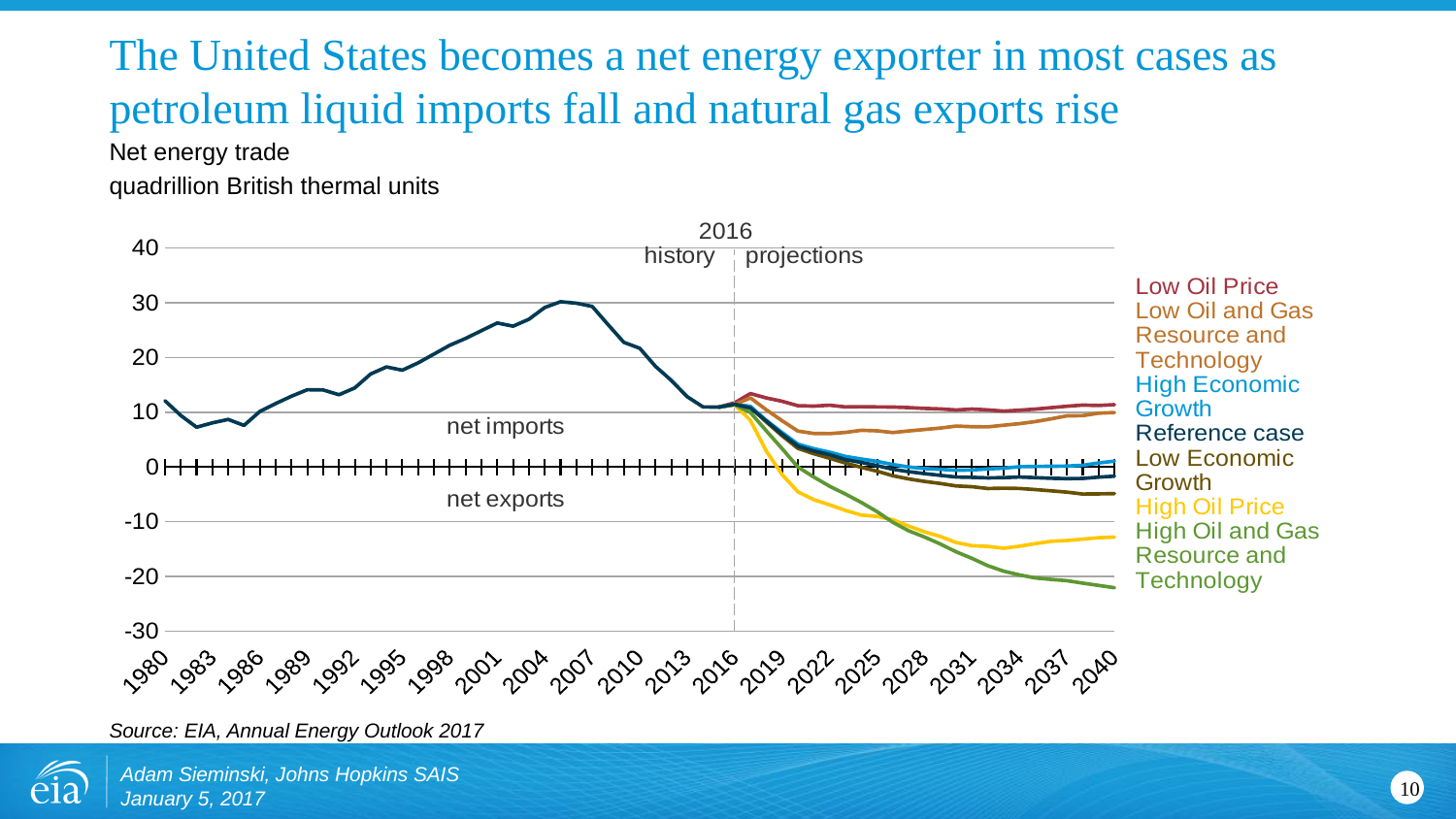
In 2040, is the value for the High Oil and Gas Resource and Technology case greater or less than -10? less Does the historical net energy trade line rise or fall between 2005 and 2016? fall In 2040, which is larger: the Reference case or the Low Economic Growth case? Reference case Is the peak historical value around 2005 greater or less than 20? greater What kind of chart is shown on the slide? line chart How many scenarios does the legend list? 7 In 2040, which is larger: the High Oil Price case or the High Oil and Gas Resource and Technology case? High Oil Price In 2040, is the value for the High Oil Price case greater or less than -10? less Which scenario has the highest net energy trade value in 2040? Low Oil Price In what units is net energy trade measured on the chart? quadrillion British thermal units Which scenario has the lowest net energy trade value in 2040? High Oil and Gas Resource and Technology